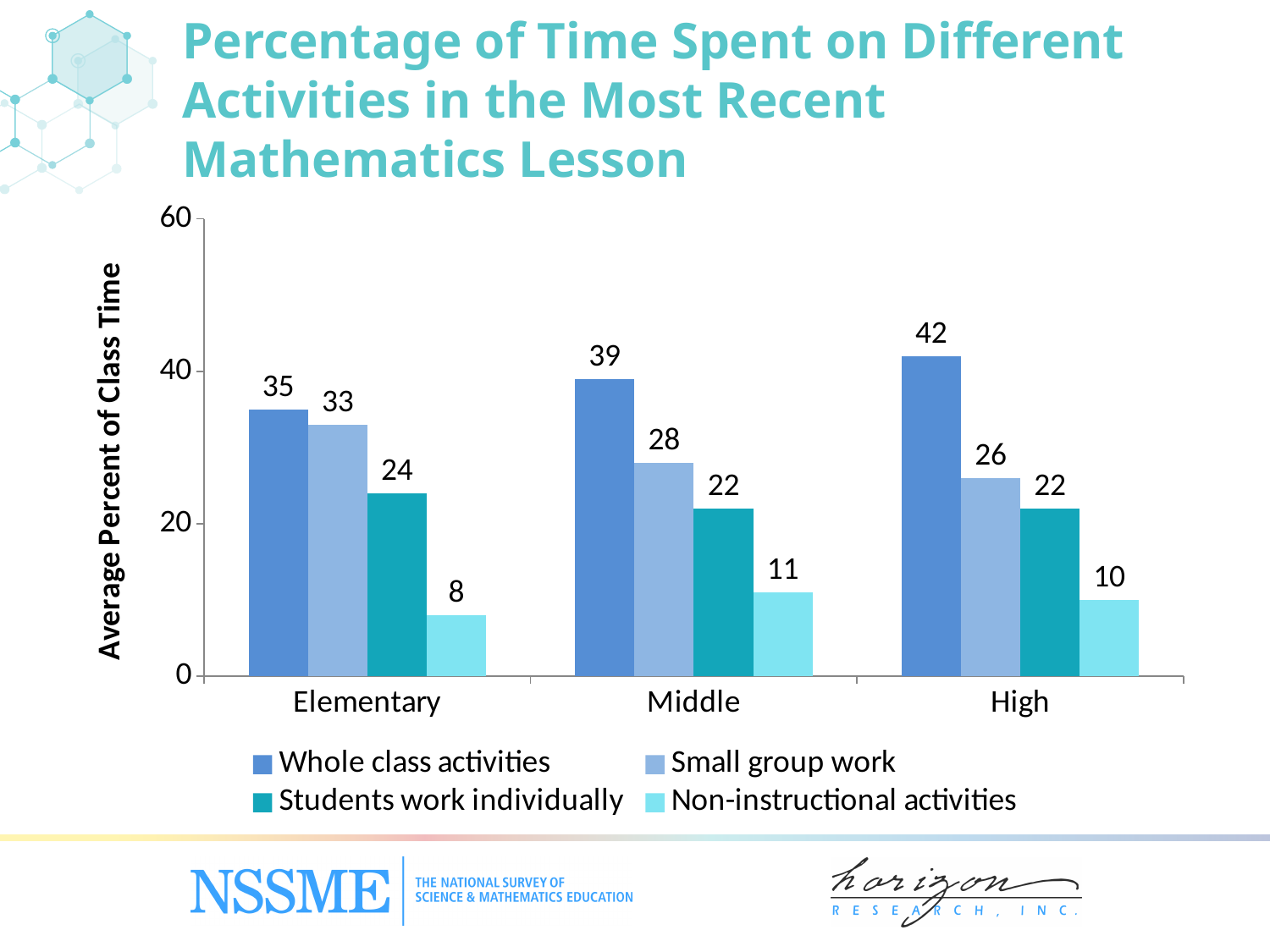
What kind of chart is shown on the slide? Bar chart How many categories are shown on the x axis? 3 Which is larger: Small group work for Elementary or Small group work for Middle? Elementary What is the label of the vertical axis? Average Percent of Class Time How many series does the legend list? 4 What is the value for Non-instructional activities in the Middle category? 11 What is the value for Small group work in the High category? 26 Which category has the lowest value for Non-instructional activities? Elementary What is the value for Whole class activities in the Elementary category? 35 What is the difference between Whole class activities and Small group work in the High category? 16 Is the value for Whole class activities in the High category greater or less than 40? greater Which category has the highest value for Whole class activities? High